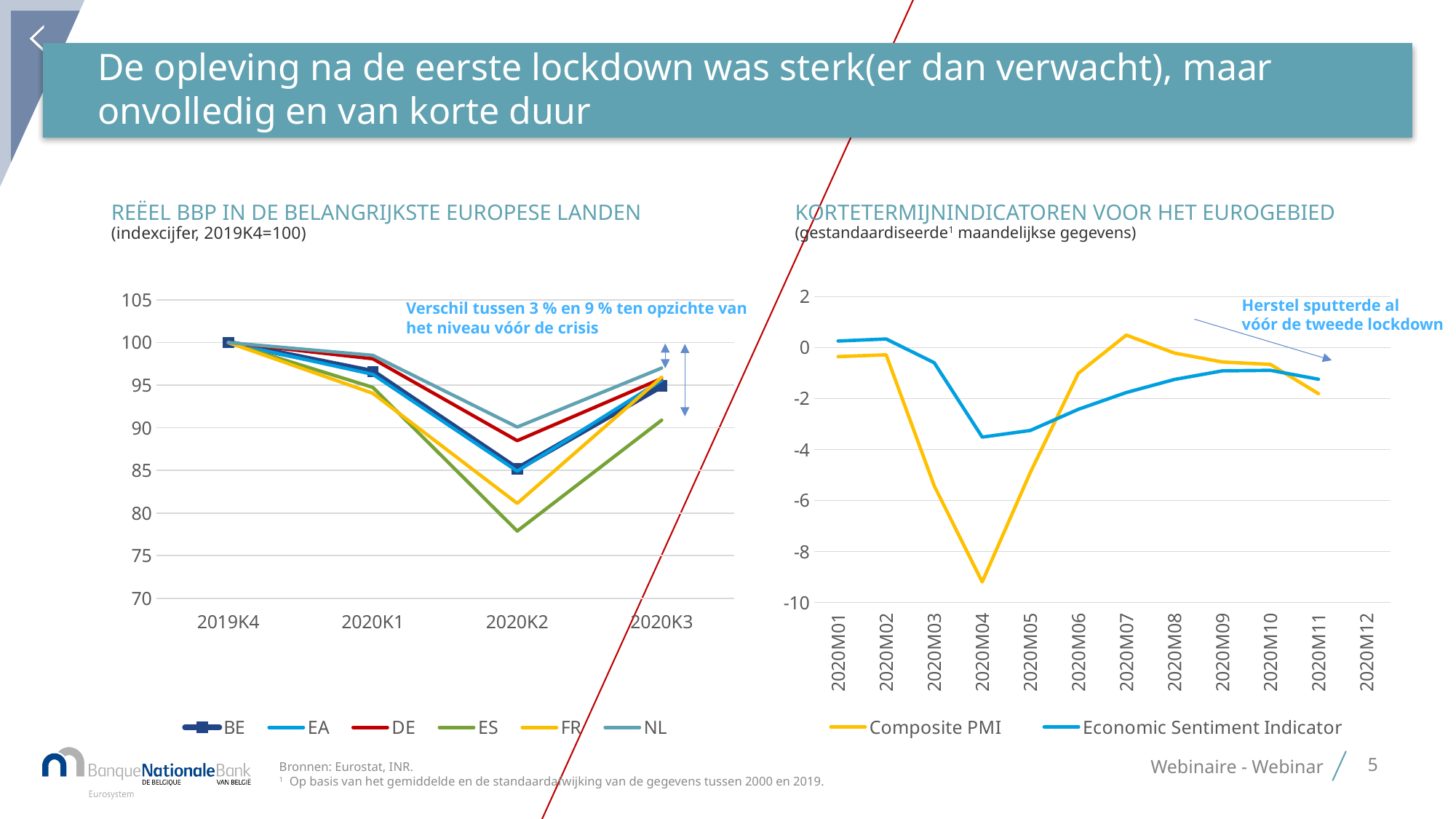
How many quarters are shown on the x axis of the left chart (REËEL BBP)? 4 In the left chart (REËEL BBP), which series has the highest value in 2020K2? NL In the right chart (KORTETERMIJNINDICATOREN), in which month does the Composite PMI reach its lowest value? 2020M04 How many series does the legend of the right chart (KORTETERMIJNINDICATOREN VOOR HET EUROGEBIED) list? 2 What kind of chart is the left chart, 'REËEL BBP IN DE BELANGRIJKSTE EUROPESE LANDEN'? Line chart In the left chart (REËEL BBP), is the value for DE in 2020K2 greater or less than 90? less In the right chart (KORTETERMIJNINDICATOREN), does the Composite PMI rise or fall from 2020M02 to 2020M04? Fall How many series does the legend of the left chart (REËEL BBP) list? 6 In the left chart (REËEL BBP), which is larger in 2020K3: the value for NL or the value for ES? NL In the right chart (KORTETERMIJNINDICATOREN), is the Composite PMI value in 2020M04 greater or less than -8? less In the left chart (REËEL BBP), is the value for ES in 2020K2 greater or less than 80? less In the left chart (REËEL BBP), which country has the lowest value in 2020K2? ES